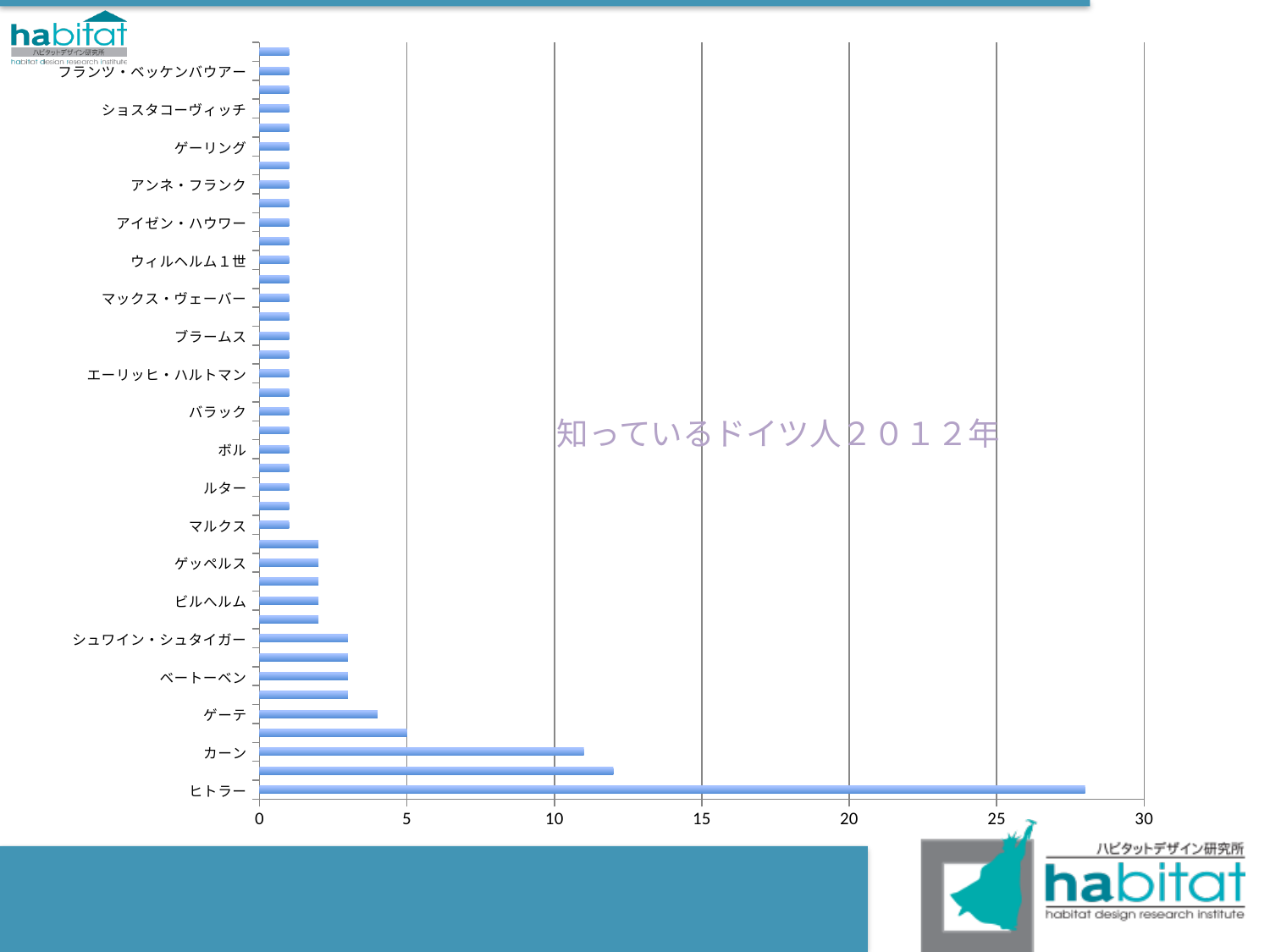
What is the maximum value shown on the horizontal axis? 30 What kind of chart is shown on the slide? bar chart Is the value for ゲーテ greater or less than 5? less What is the title of the chart? 知っているドイツ人２０１２年 Is the value for マルクス greater or less than 5? less Is the value for カーン greater or less than 10? greater Which has a larger value, ベートーベン or ルター? ベートーベン Which has a larger value, カーン or ゲーテ? カーン Which category has the highest value in the chart? ヒトラー Which has a larger value, ヒトラー or カーン? ヒトラー